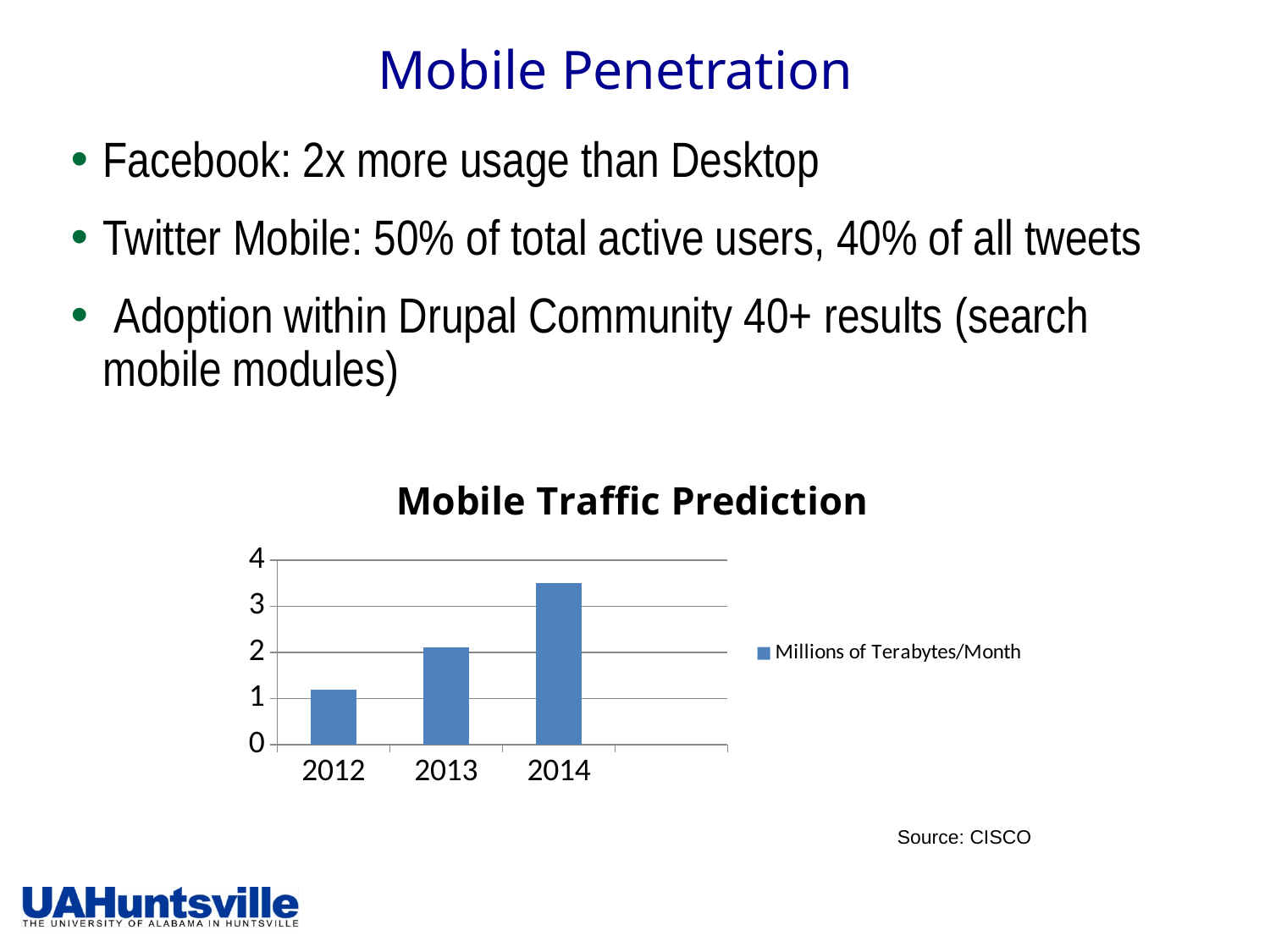
How many years are shown on the x axis of the Mobile Traffic Prediction chart? 3 Do the values in the Mobile Traffic Prediction chart rise or fall from 2012 to 2014? rise In the Mobile Traffic Prediction chart, is the value for 2014 greater or less than 4? less In the Mobile Traffic Prediction chart, is the value for 2013 greater or less than 3? less How many series does the legend of the Mobile Traffic Prediction chart list? 1 In the Mobile Traffic Prediction chart, which is larger, the value for 2013 or the value for 2014? 2014 What kind of chart is the Mobile Traffic Prediction chart? bar chart In the Mobile Traffic Prediction chart, is the value for 2014 greater or less than 3? greater What is the legend entry in the Mobile Traffic Prediction chart? Millions of Terabytes/Month Which year has the lowest value in the Mobile Traffic Prediction chart? 2012 Which year has the highest value in the Mobile Traffic Prediction chart? 2014